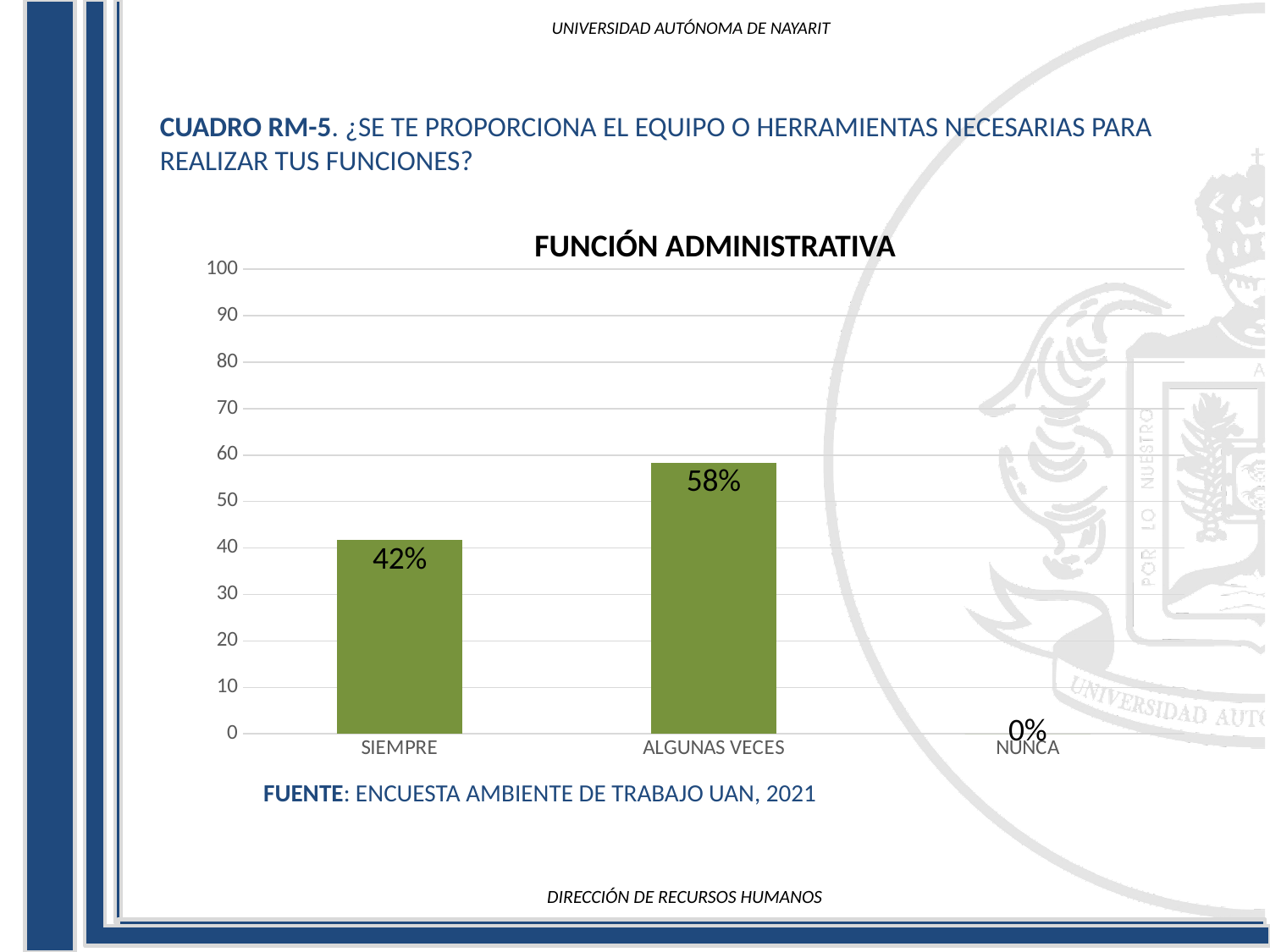
What is the highest value shown on the y axis? 100 How many categories are shown on the x axis? 3 What is the title of the chart? FUNCIÓN ADMINISTRATIVA What is the value for ALGUNAS VECES? 58% What is the value for NUNCA? 0% Which is larger, the value for SIEMPRE or the value for ALGUNAS VECES? ALGUNAS VECES What kind of chart is shown on the slide? bar chart What is the value for SIEMPRE? 42% Is the value for SIEMPRE greater or less than 50? less Which category has the highest value? ALGUNAS VECES Which category has the lowest value? NUNCA What is the difference between the values for ALGUNAS VECES and SIEMPRE? 16%